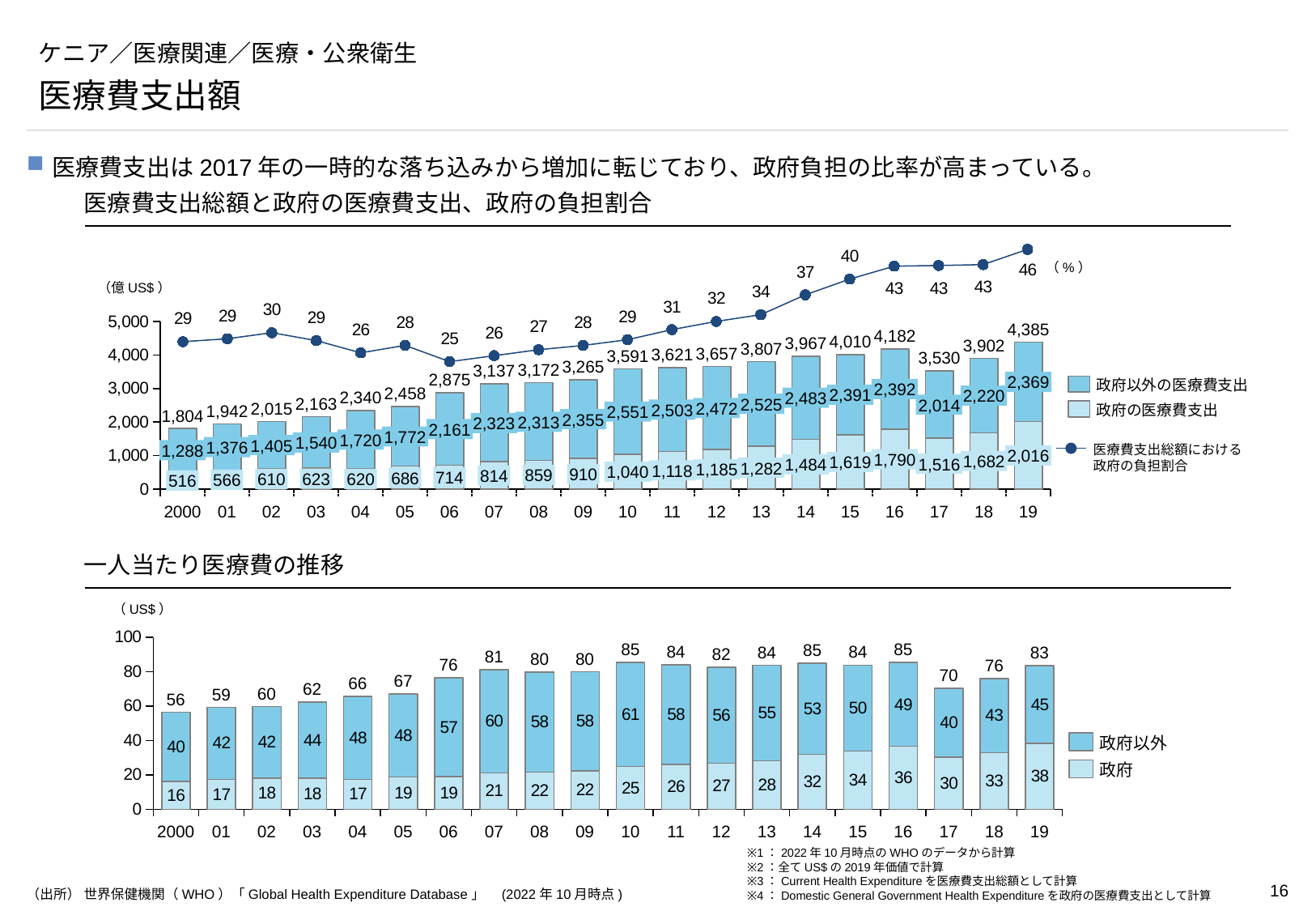
In the top chart, what is the total health expenditure (top label) for 2017? 3,530 In the top chart, what is the difference between the total health expenditure in 2019 and in 2018? 483 In the top chart, what is the government share (医療費支出総額における政府の負担割合) for 2019? 46 In the top chart, in which year is the government share line at its lowest? 2006 In the top chart, which year has the highest total health expenditure? 2019 In the top chart (医療費支出総額と政府の医療費支出、政府の負担割合), what is the value of 政府の医療費支出 for 2019? 2,016 In the bottom chart, which year has the lowest total per-capita health expenditure? 2000 How many series does the legend of the top chart list? 3 In the bottom chart, what is the difference between the 政府以外 values for 2016 and 2017? 9 What kind of chart is the bottom chart (一人当たり医療費の推移)? Stacked bar chart In the bottom chart, what is the value of 政府 for 2019? 38 In the bottom chart, which year has the larger total per-capita expenditure, 2017 or 2018? 2018